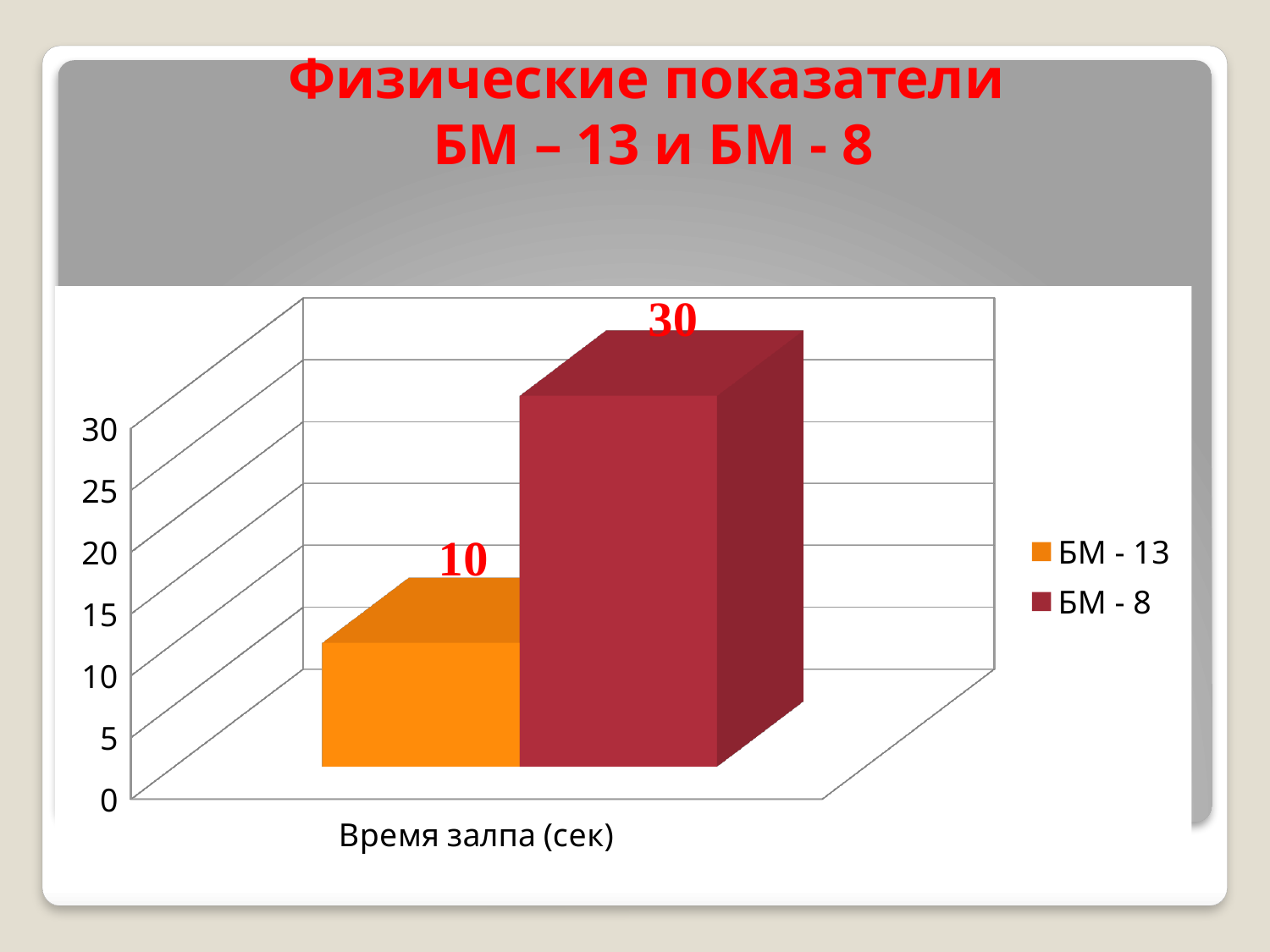
What is the difference between the values for БМ - 8 and БМ - 13? 20 What kind of chart is shown on the slide? bar chart Which series has the highest value in the chart? БМ - 8 What is the category label shown on the x axis of the chart? Время залпа (сек) How many series does the legend list? 2 What is the value for БМ - 8 in the chart? 30 What is the value for БМ - 13 in the chart? 10 Which series has the lowest value in the chart? БМ - 13 Is the value for БМ - 8 greater or less than 20? greater Is the value for БМ - 13 greater or less than 15? less What colour is the bar for БМ - 13? orange Which series has the higher value, БМ - 13 or БМ - 8? БМ - 8